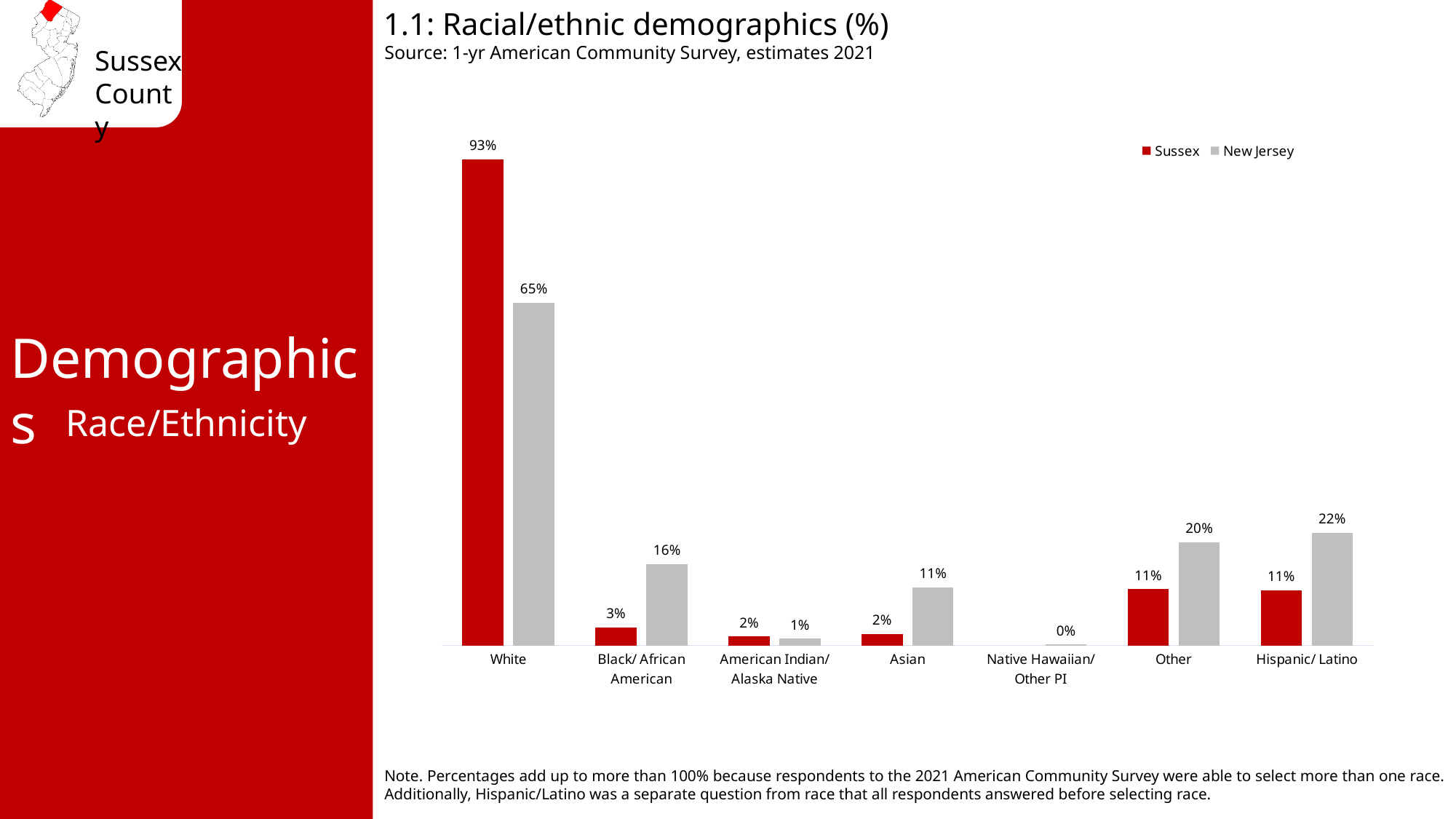
Which category has the highest New Jersey value? White Which is larger for Other: the Sussex value or the New Jersey value? New Jersey How many series does the legend list? 2 What is the difference between the Sussex and New Jersey values for White? 28% How many categories are shown on the x axis? 7 What is the Sussex value for White? 93% What is the title of the chart? 1.1: Racial/ethnic demographics (%) What is the Sussex value for Asian? 2% What kind of chart is shown on the slide? Bar chart Which category has the lowest New Jersey value? Native Hawaiian/ Other PI What is the New Jersey value for Black/ African American? 16% What is the New Jersey value for Hispanic/ Latino? 22%